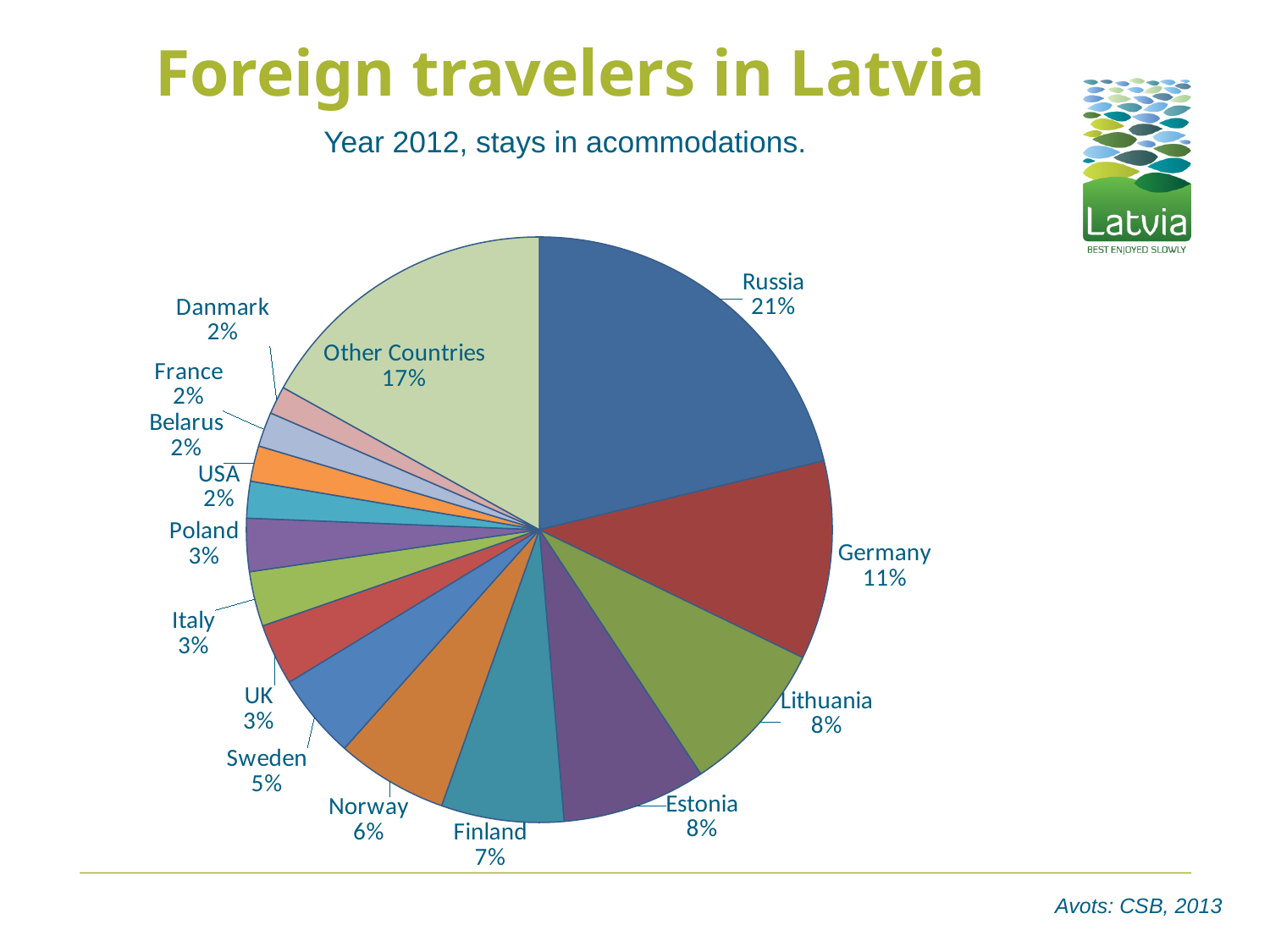
Which has a larger share, Lithuania or Finland? Lithuania What is the difference in percentage points between Russia and Germany? 10 What year does the chart's subtitle say the data is for? 2012 Which has a larger share, Norway or Sweden? Norway What percentage is shown for Finland? 7% What percentage is shown for Other Countries? 17% How many slices does the pie chart have? 15 What kind of chart is shown on the slide? pie chart What share of the pie is labelled Germany? 11% What share of foreign travelers in Latvia came from Russia? 21% What is the combined share of Lithuania and Estonia? 16% Which country has the largest slice of the pie? Russia